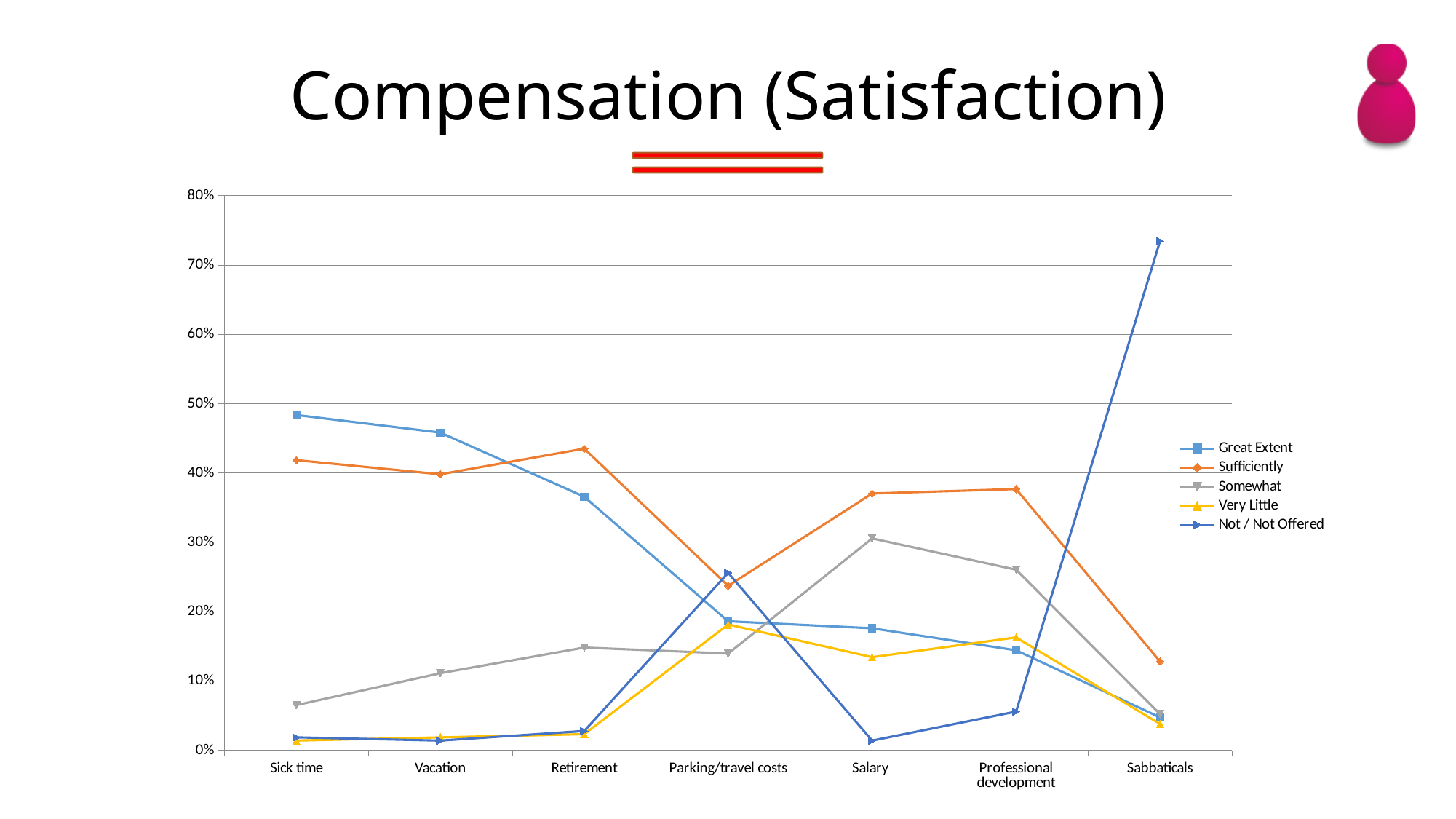
How many series does the legend list? 5 Is the value for Somewhat at Sick time greater or less than 10%? less Is the value for Not / Not Offered at Sabbaticals greater or less than 70%? greater How many categories are shown along the x axis? 7 Does the Great Extent series rise or fall overall from Sick time to Sabbaticals? fall Is the value for Great Extent at Sick time greater or less than 40%? greater Which category has the highest value for the Not / Not Offered series? Sabbaticals What kind of chart is shown on the slide? line chart Which category has the highest value for the Somewhat series? Salary What is the title of the slide containing the chart? Compensation (Satisfaction) Which category has the lowest value for the Great Extent series? Sabbaticals At Retirement, which is larger: Sufficiently or Great Extent? Sufficiently